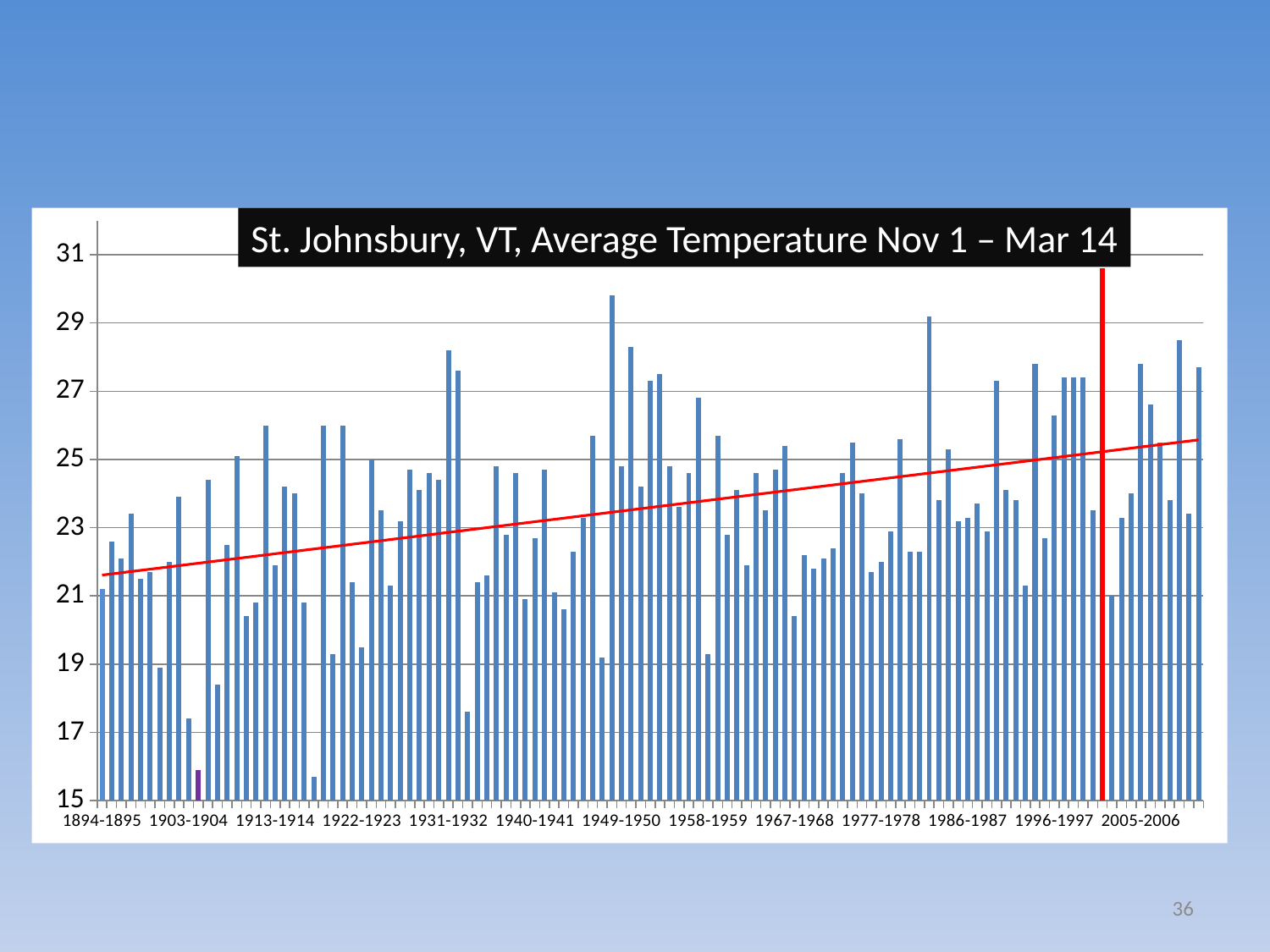
Is the value for 1996-1997 greater or less than 25? greater Is the value for 1940-1941 greater or less than 25? less Is the shortest bar on the chart greater or less than 17? less Does the red trend line show values rising or falling from left to right along the x axis? rising What is the title of the chart? St. Johnsbury, VT, Average Temperature Nov 1 – Mar 14 What is the lowest value shown on the y axis? 15 What kind of chart is shown on the slide? bar chart